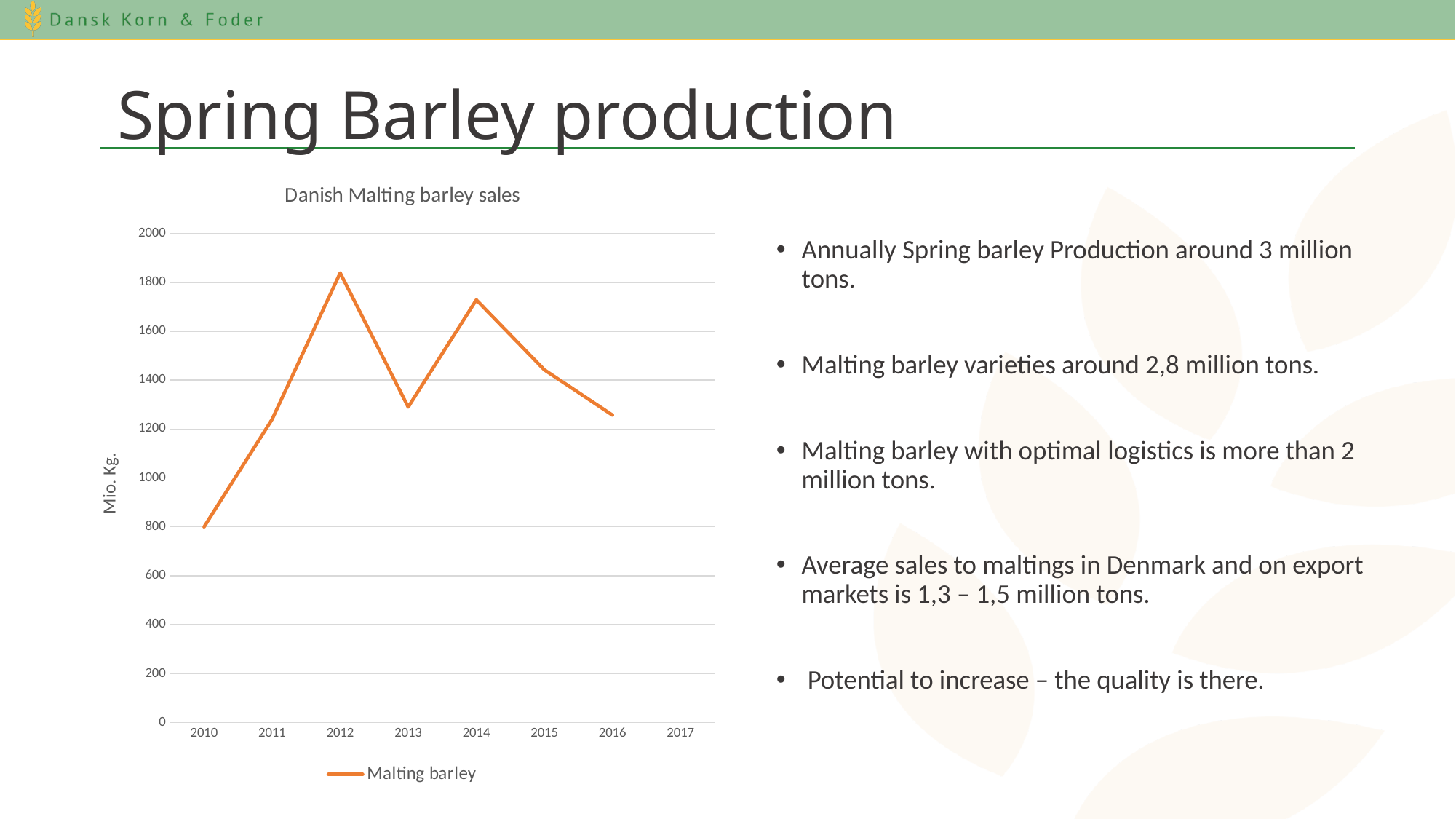
What is the title of the chart? Danish Malting barley sales What is the label on the vertical axis of the chart? Mio. Kg. Do the values rise or fall from 2014 to 2016? fall In which year is the malting barley sales value highest? 2012 In which year is the malting barley sales value lowest? 2010 What kind of chart is shown on the slide? line chart Which year has the larger value, 2011 or 2015? 2015 Is the value for 2016 greater or less than 1400? less Is the value for 2014 greater or less than 1600? greater How many series does the chart legend list? 1 Is the value for 2012 greater or less than 1800? greater How many years have a plotted value on the line? 7